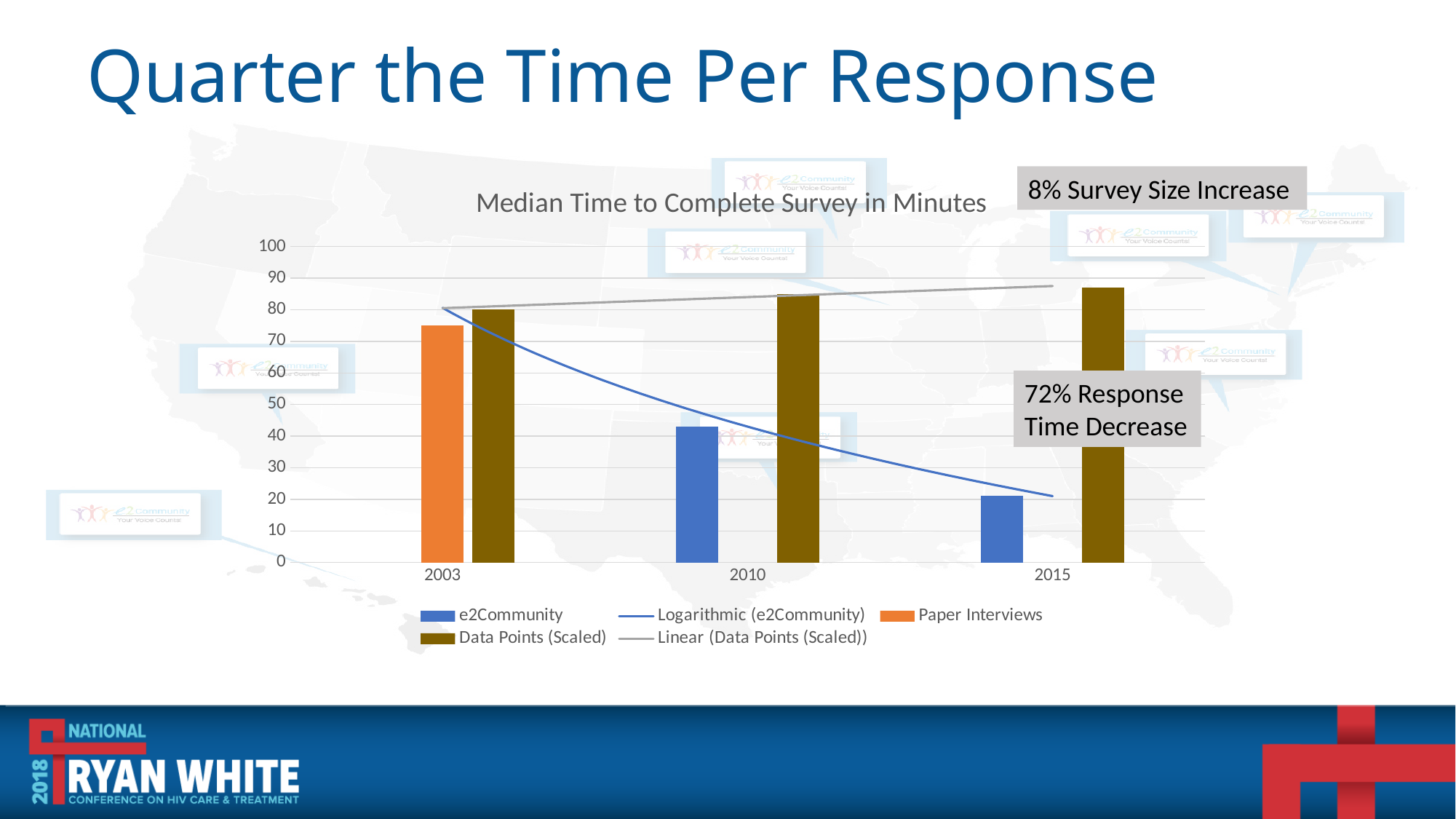
Do the Data Points (Scaled) bars rise or fall from 2003 to 2015? rise Which year has the larger e2Community value, 2010 or 2015? 2010 Is the Data Points (Scaled) value for 2015 greater or less than 80? greater Which bar is the lowest on the chart? e2Community in 2015 Is the e2Community value for 2010 greater or less than 50? less Is the Paper Interviews value for 2003 greater or less than 70? greater How many years are shown on the x axis of the chart? 3 What kind of chart is shown on the slide? bar chart What is the title of the chart? Median Time to Complete Survey in Minutes How many entries does the chart legend list? 5 Which series is shown in orange? Paper Interviews